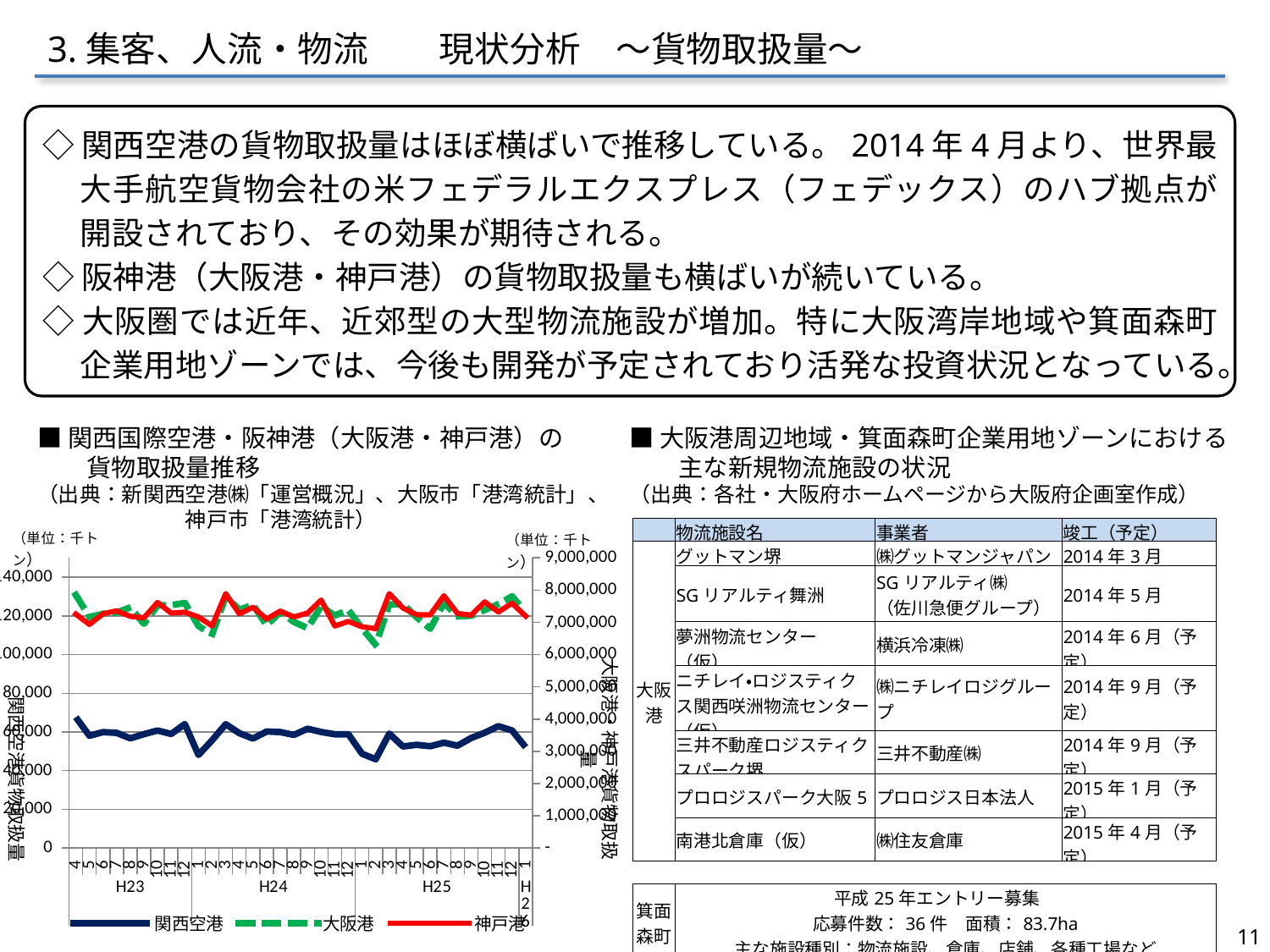
Does the 関西空港 series show a strong rising trend, a strong falling trend, or stay roughly flat across the x axis? roughly flat What kind of chart is shown on the slide? line chart Is the value for 関西空港 in month 4 of H23 greater or less than 40,000? greater Is the value for 大阪港 in month 12 of H25 greater or less than 8,000,000? less What unit is shown for the chart's axes? 千トン Which series are listed in the chart legend? 関西空港, 大阪港, 神戸港 Is the value for 関西空港 in month 4 of H23 greater or less than 80,000? less How many series does the chart legend list? 3 What is the highest tick value on the right-hand axis of the chart? 9,000,000 What is the highest tick value on the left-hand axis of the chart? 140,000 How many fiscal-year groups (H23, H24, ...) are labelled on the x axis of the chart? 4